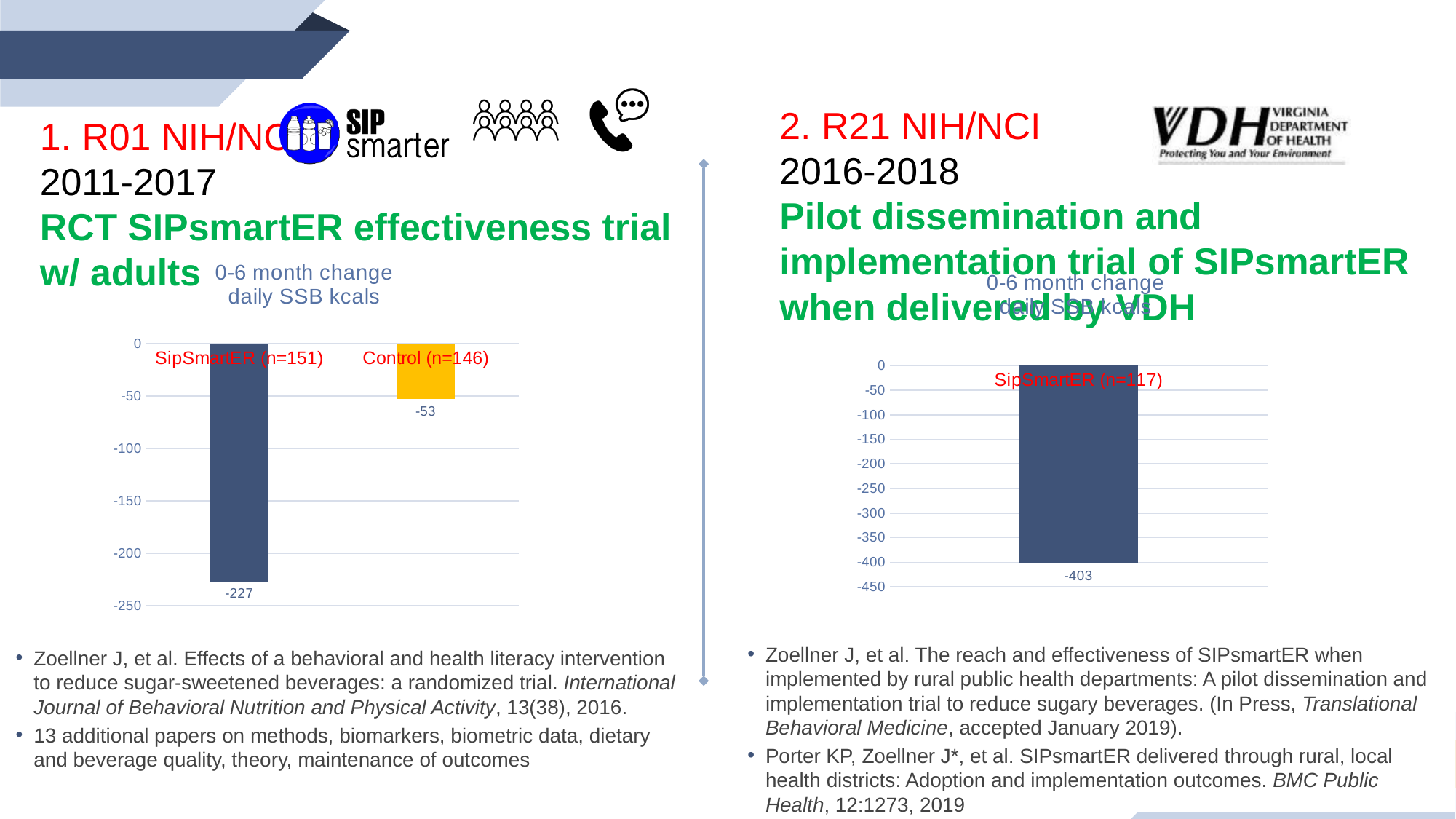
What type of chart is the left chart? Bar chart In the left chart, is the value for Control (n=146) greater or less than -50? less In the left chart, what colour is the Control (n=146) bar? Yellow What is the title of the right chart? 0-6 month change daily SSB kcals In the right chart, is the value for SipSmartER (n=117) greater or less than -400? less How many bars are plotted in the right chart? 1 In the right chart, what is the 0-6 month change in daily SSB kcals for SipSmartER (n=117)? -403 How many bars are plotted in the left chart? 2 In the left chart, which group shows the larger reduction in daily SSB kcals? SipSmartER (n=151) In the left chart, what is the 0-6 month change in daily SSB kcals for Control (n=146)? -53 In the left chart, what is the 0-6 month change in daily SSB kcals for SipSmartER (n=151)? -227 In the left chart, what is the difference between the SipSmartER (n=151) value and the Control (n=146) value? 174